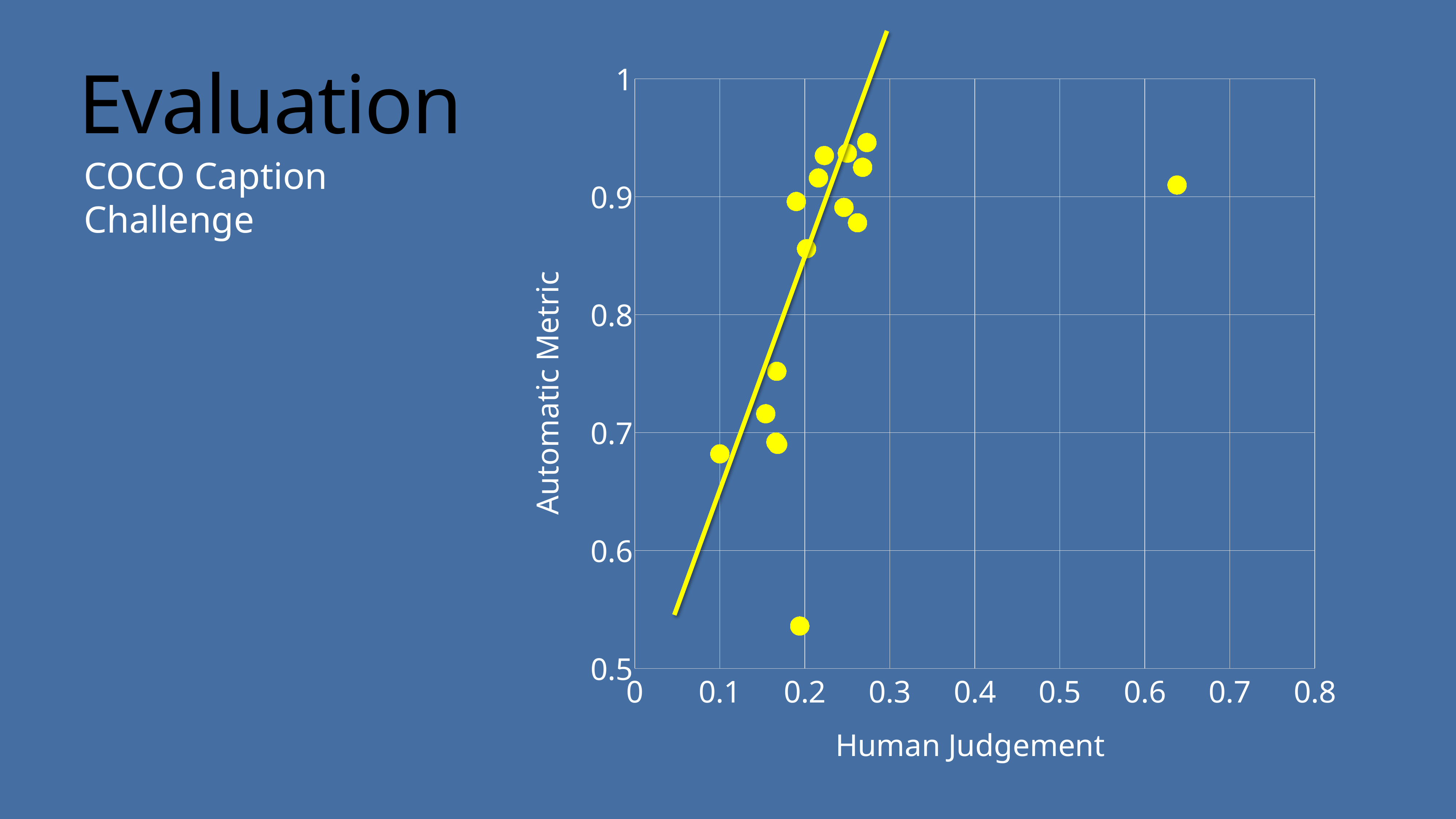
Is the Automatic Metric value of the lowest point greater or less than 0.6? less Is the Human Judgement value of the rightmost point greater or less than 0.6? greater Is the Automatic Metric value of the highest point greater or less than 0.9? greater What is the label of the x axis? Human Judgement What kind of chart is shown on the slide? scatter plot Which has the larger Automatic Metric value: the rightmost point or the lowest point? the rightmost point Does the trend line show Automatic Metric rising or falling as Human Judgement increases? rising How many points have a Human Judgement value greater than 0.4? 1 What is the highest value shown on the y axis? 1 What is the label of the y axis? Automatic Metric